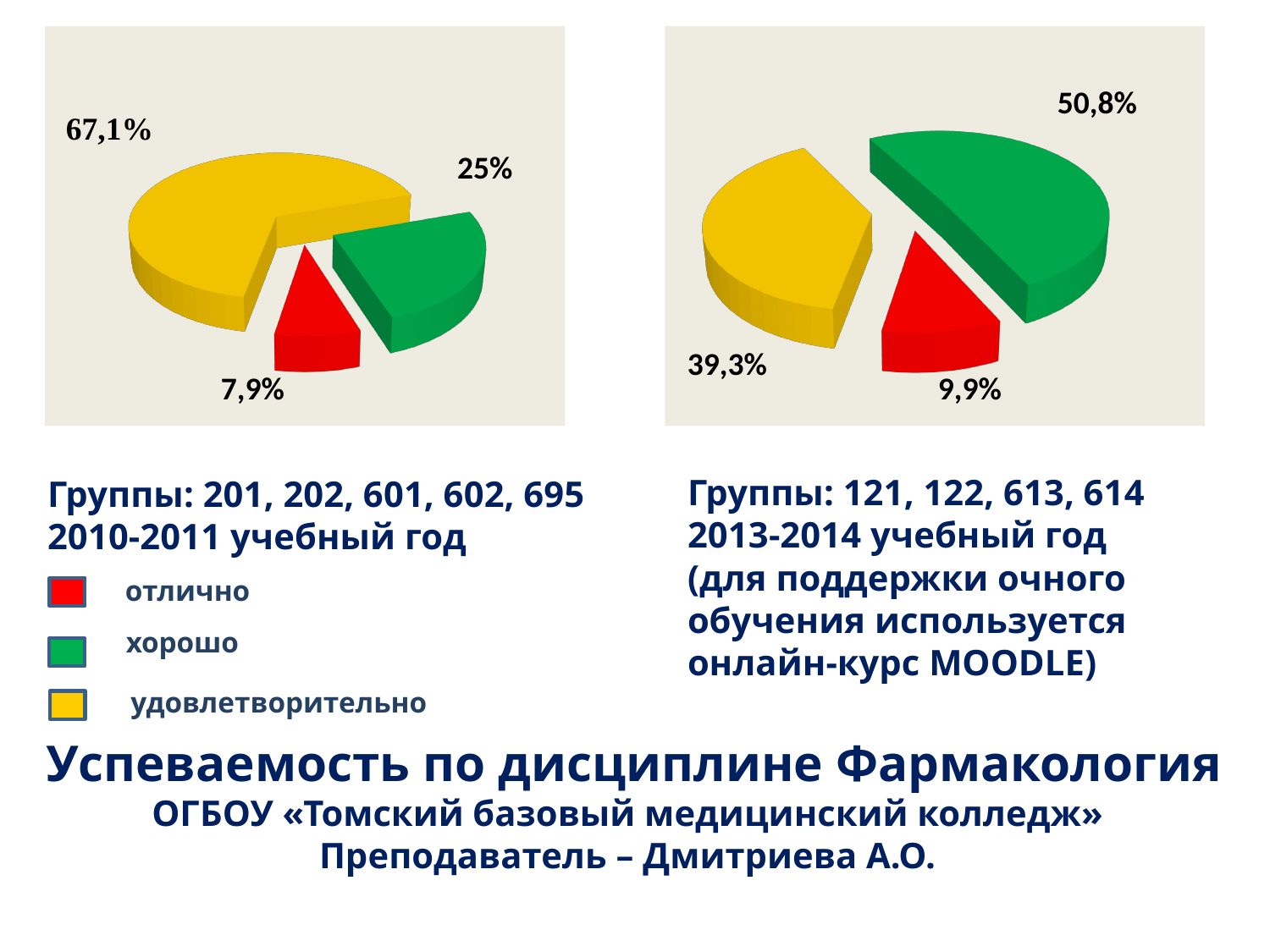
Which colour represents хорошо in the legend? green What type of chart is used on this slide? pie chart On the left pie chart (2010-2011 учебный год), what share is labelled for the red slice (отлично)? 7,9% On the right pie chart (2013-2014 учебный год), what share is labelled for the red slice (отлично)? 9,9% On the right pie chart (2013-2014 учебный год), what share is labelled for the green slice (хорошо)? 50,8% Which is larger: the хорошо share on the left pie chart (25%) or the хорошо share on the right pie chart (50,8%)? the right pie chart (50,8%) On the left pie chart (2010-2011 учебный год), what share is labelled for the yellow slice (удовлетворительно)? 67,1% On the right pie chart (2013-2014 учебный год), what is the difference between the хорошо share and the удовлетворительно share? 11,5% On the right pie chart (2013-2014 учебный год), which category has the smallest slice? отлично On the left pie chart (2010-2011 учебный год), which category has the largest slice? удовлетворительно How many categories does the legend list? 3 How many slices does the left pie chart (2010-2011 учебный год) have? 3